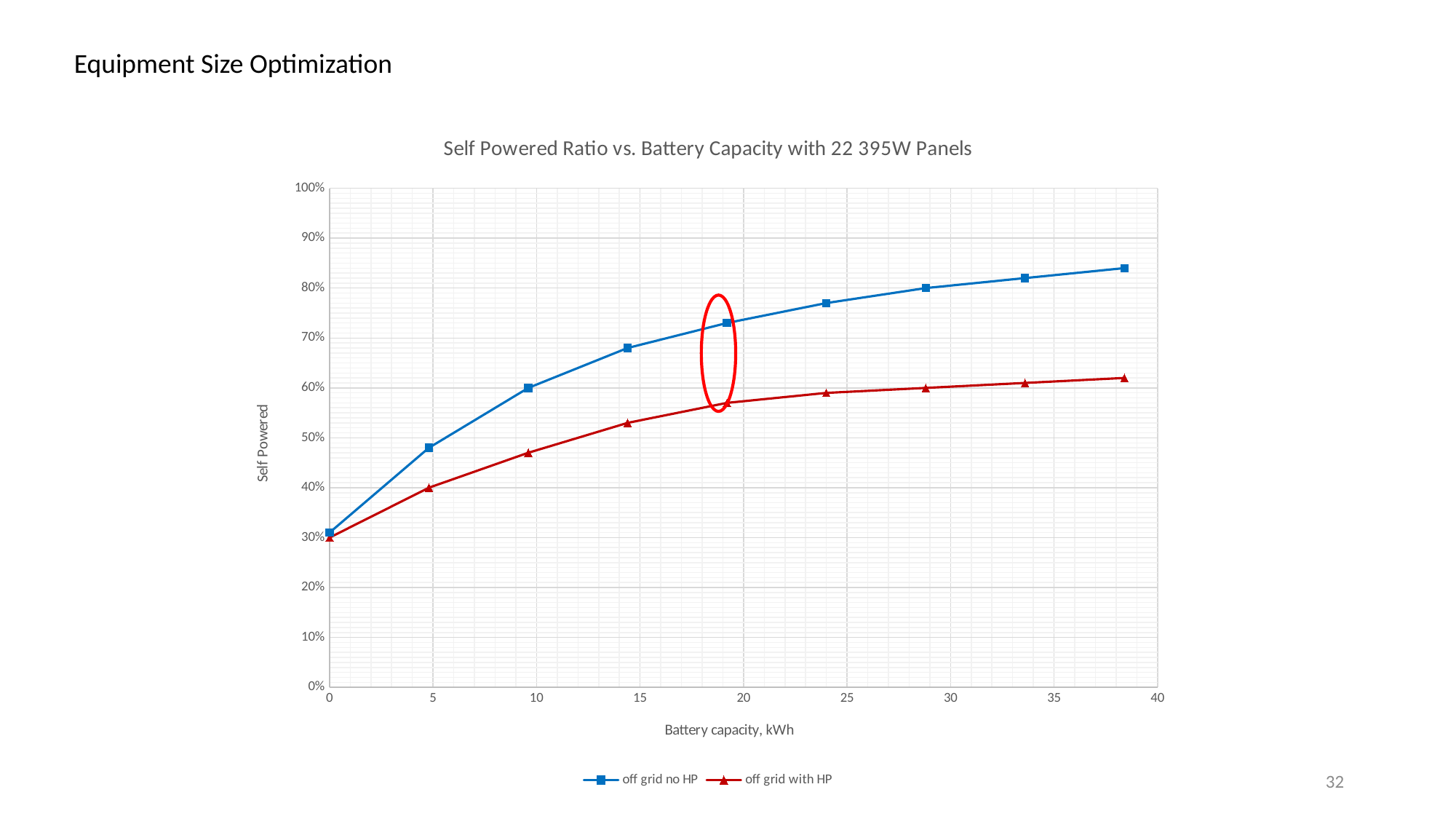
Does the self powered ratio for 'off grid with HP' rise or fall as battery capacity increases? rise Is the value for 'off grid with HP' at the highest battery capacity plotted greater or less than 70%? less Is the value for 'off grid no HP' at a battery capacity of 5 kWh greater or less than 40%? greater What kind of chart is shown on the slide? line chart How many series does the legend list? 2 What is the value for 'off grid with HP' at a battery capacity of 0 kWh? 30% Is the value for 'off grid with HP' at a battery capacity of 15 kWh greater or less than 60%? less How many data points are plotted for the 'off grid no HP' series? 9 Which series has the higher self powered ratio at a battery capacity of 20 kWh, 'off grid no HP' or 'off grid with HP'? off grid no HP What is the label of the x axis? Battery capacity, kWh What is the title of the chart? Self Powered Ratio vs. Battery Capacity with 22 395W Panels